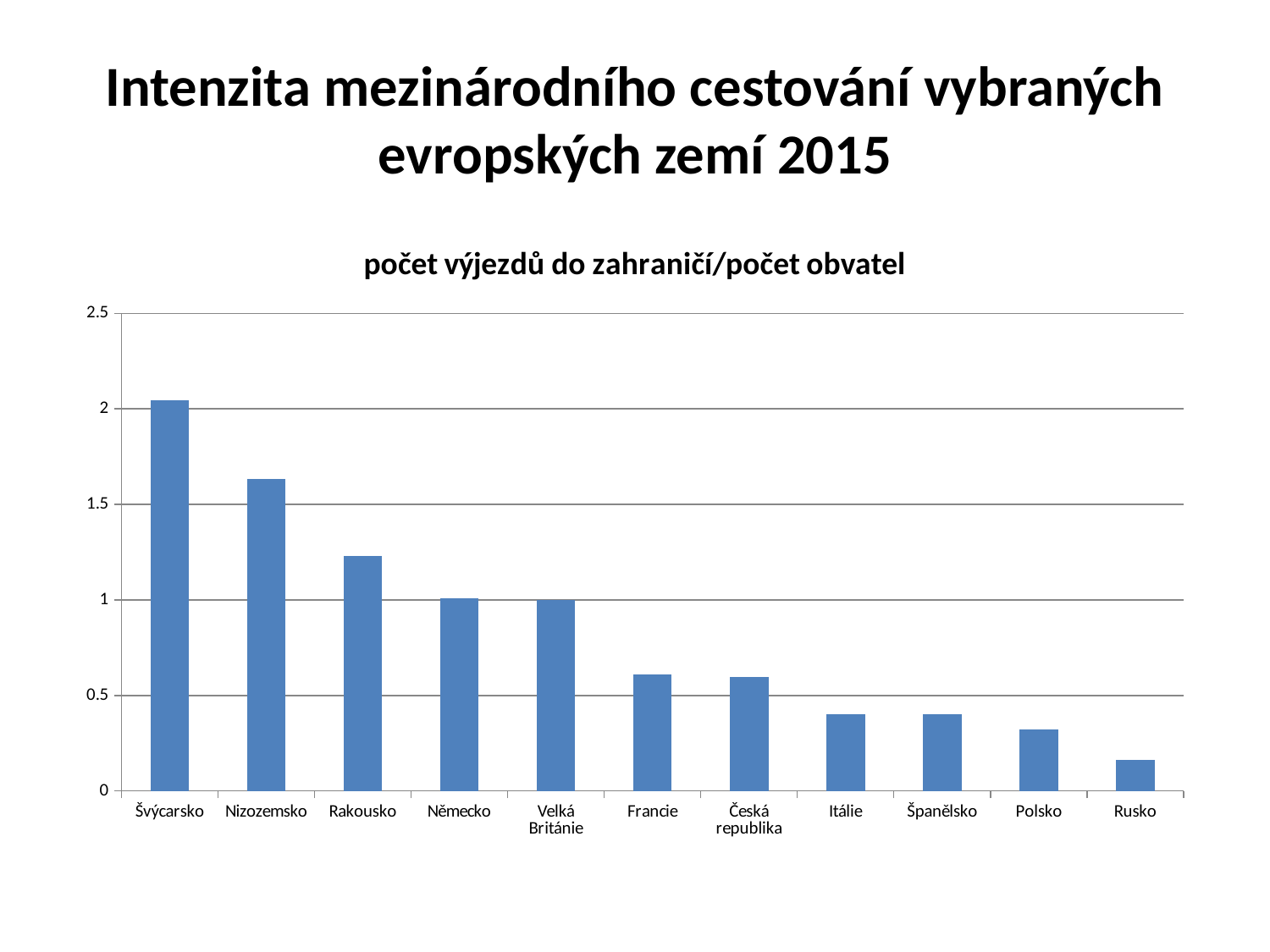
Which country has the lowest value in the chart? Rusko Is the value for Nizozemsko greater or less than 1.5? greater Is the value for Rakousko greater or less than 1? greater What is the title printed above the chart? počet výjezdů do zahraničí/počet obvatel Do the values rise or fall moving from left to right along the x axis? fall Is the value for Rusko greater or less than 0.5? less Which has the larger value, Polsko or Rusko? Polsko What kind of chart is shown on the slide? bar chart How many countries are shown on the x axis of the chart? 11 Which has the larger value, Nizozemsko or Rakousko? Nizozemsko Which country has the highest value in the chart? Švýcarsko